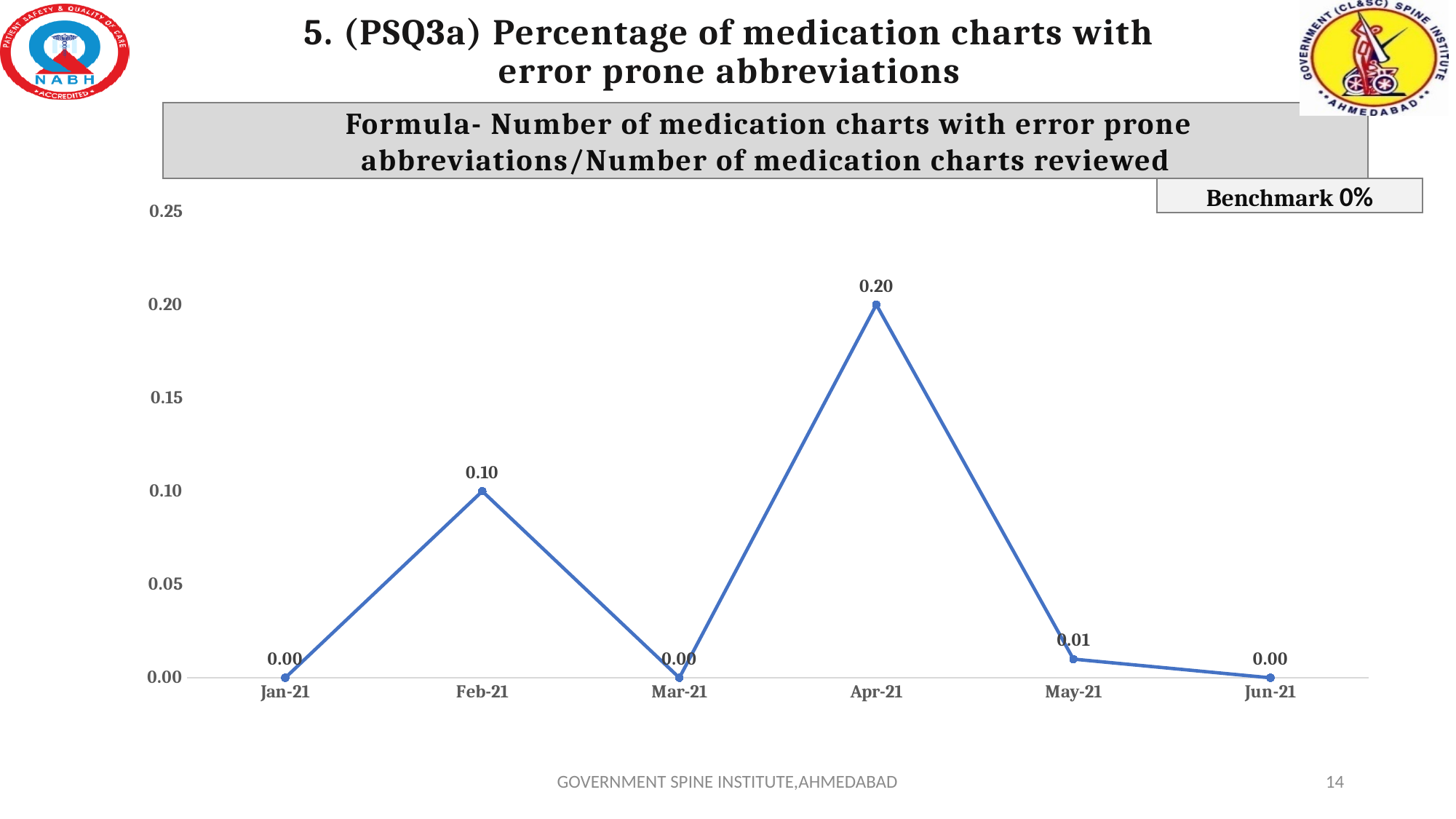
Which month has the highest value? Apr-21 Is the value for Apr-21 greater or less than 0.15? greater What is the difference between the values for Feb-21 and May-21? 0.09 What is the value for Apr-21? 0.20 What is the difference between the values for Apr-21 and Feb-21? 0.10 What benchmark value is shown on the slide? 0% What is the value for Feb-21? 0.10 Which is larger, the value for Feb-21 or the value for May-21? Feb-21 What is the value for May-21? 0.01 What kind of chart is shown on the slide? line chart What is the value for Jan-21? 0.00 How many months are plotted on the chart? 6